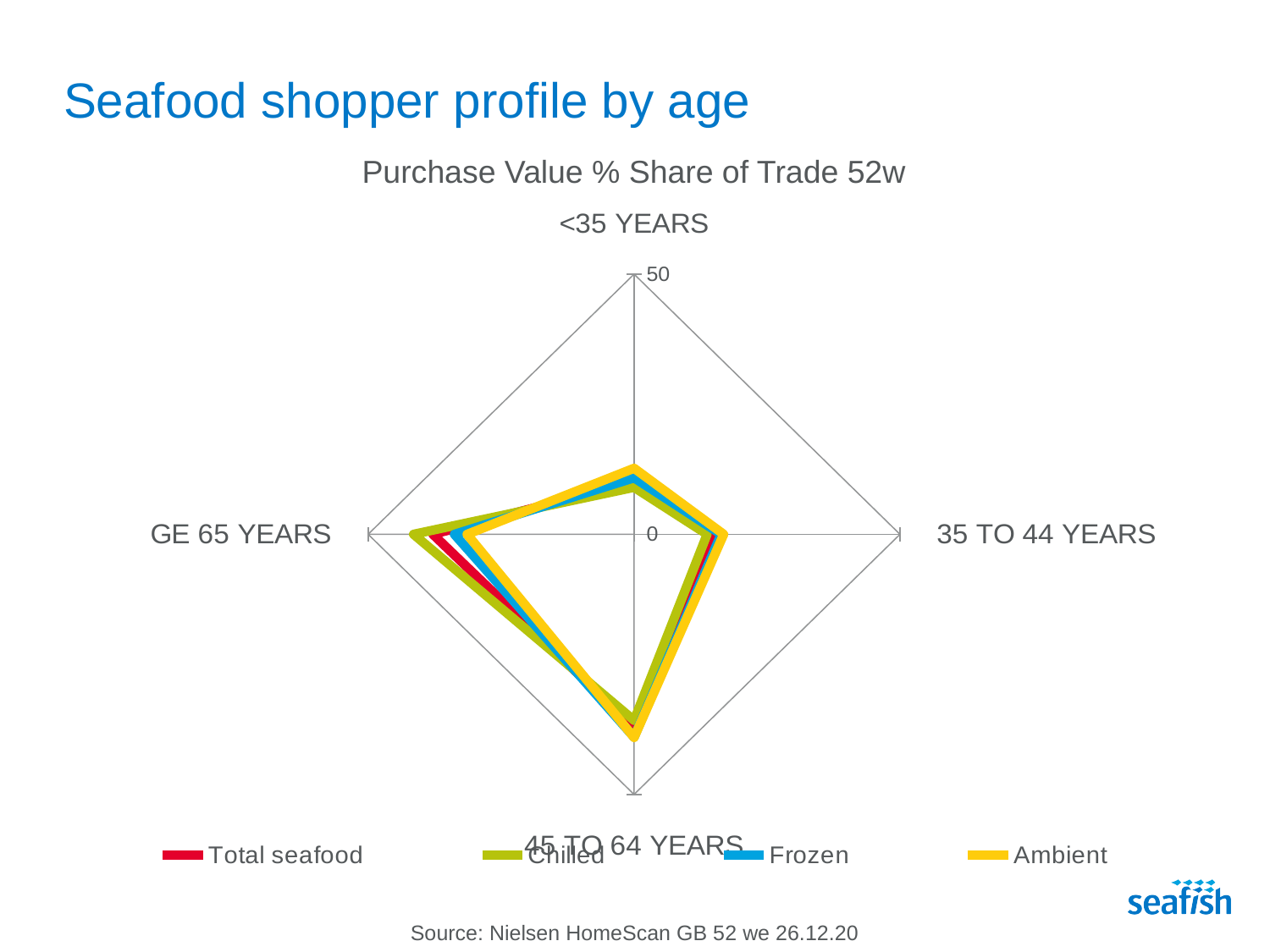
Which series is shown in yellow in the legend? Ambient For the GE 65 YEARS category, which series has the larger value: Chilled or Ambient? Chilled Which age category has the lowest value for the Chilled series? <35 YEARS Which age category has the lowest value for the Frozen series? <35 YEARS How many age categories are plotted on the chart? 4 What is the title of the chart? Purchase Value % Share of Trade 52w For the Ambient series, which is larger: the value for 45 TO 64 YEARS or the value for GE 65 YEARS? 45 TO 64 YEARS Is the value for 45 TO 64 YEARS in the Total seafood series greater or less than 50? less For the <35 YEARS category, which series has the larger value: Ambient or Chilled? Ambient What kind of chart is shown on the slide? Radar chart Which age category has the highest value for the Ambient series? 45 TO 64 YEARS How many series does the legend list? 4